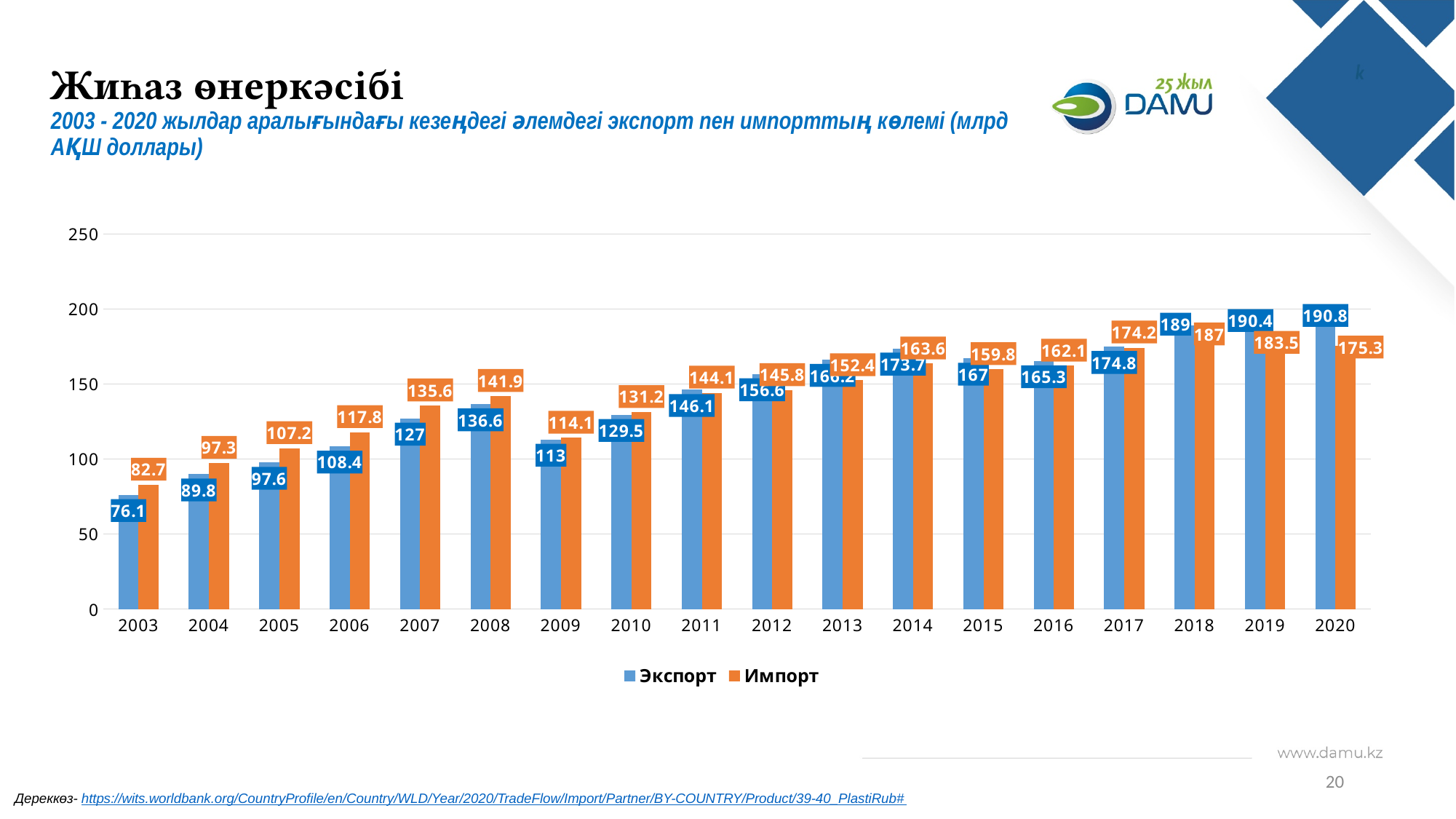
In 2009, which is larger, Экспорт or Импорт? Импорт What is the Импорт value for 2020? 175.3 What is the Экспорт value for 2003? 76.1 In which year is the Экспорт value lowest? 2003 Do the Экспорт values rise or fall from 2003 to 2008? rise How many years are shown on the x axis? 18 What is the Экспорт value for 2018? 189 What kind of chart is shown on the slide? bar chart How many series does the legend list? 2 In which year is the Импорт value highest? 2018 What is the difference between Экспорт and Импорт in 2020? 15.5 What is the difference between Экспорт and Импорт in 2018? 2